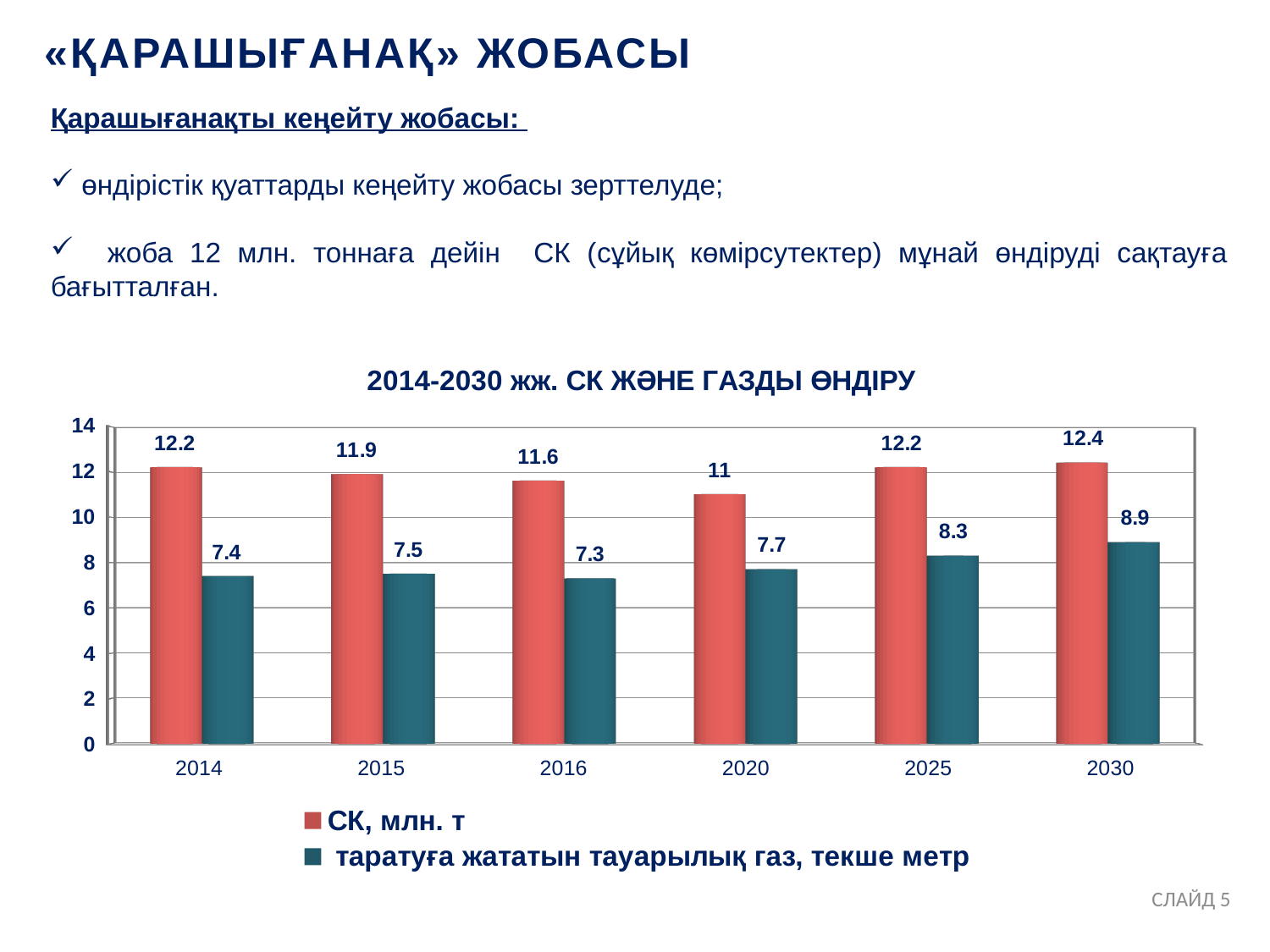
What is the value of таратуға жататын тауарылық газ, текше метр for 2030? 8.9 How many series does the chart legend list? 2 How many years are shown on the x axis of the chart? 6 What is the difference between СК, млн. т in 2030 and in 2020? 1.4 What kind of chart is shown on the slide? bar chart Which is larger: таратуға жататын тауарылық газ in 2025 or in 2015? 2025 In which year is таратуға жататын тауарылық газ, текше метр the lowest? 2016 In which year is СК, млн. т the highest? 2030 What is the value of СК, млн. т for 2020? 11 Is the value of СК, млн. т for 2016 greater or less than 10? greater What is the title of the chart? 2014-2030 жж. СК ЖӘНЕ ГАЗДЫ ӨНДІРУ What is the value of СК, млн. т for 2014? 12.2